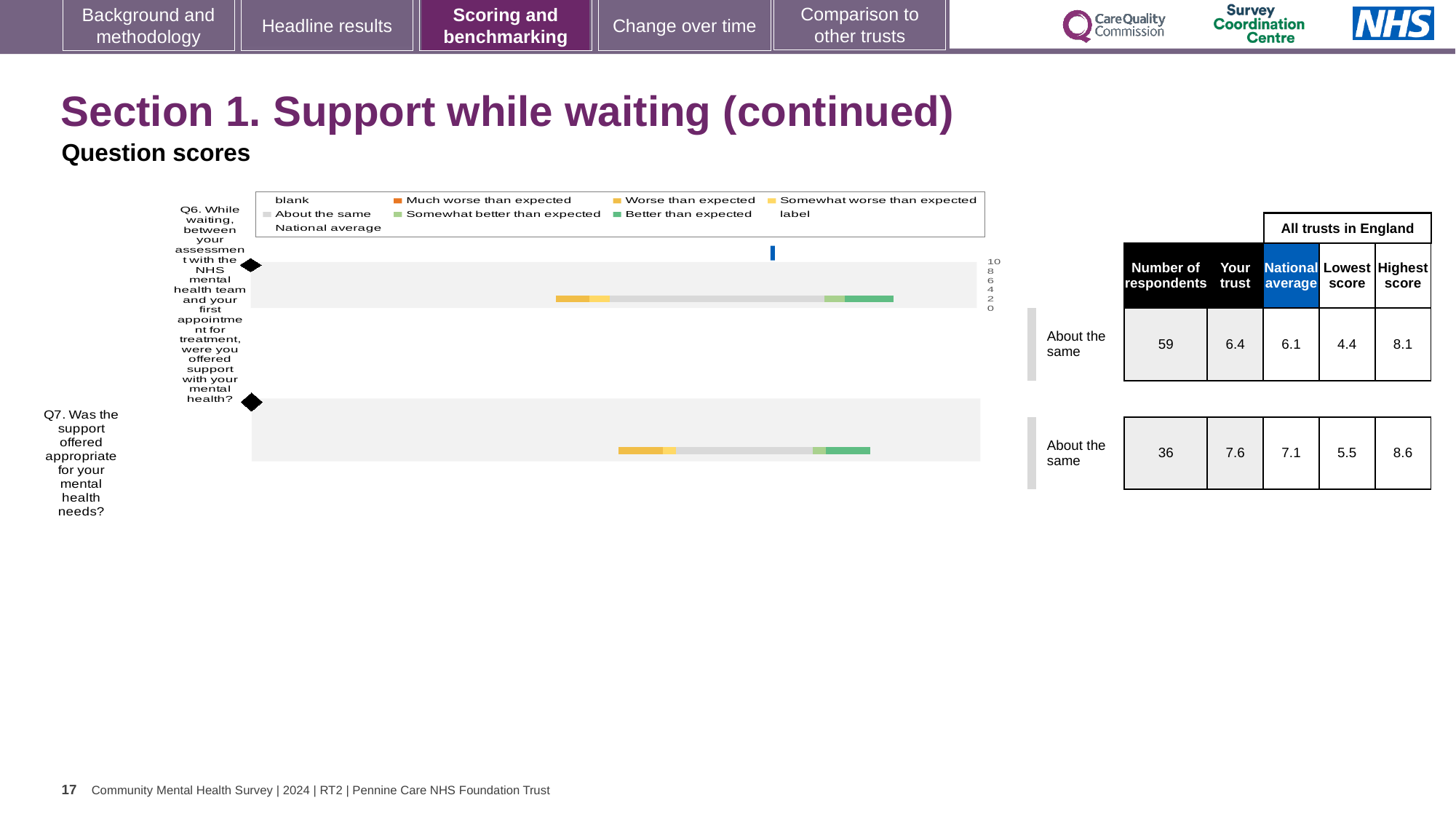
Which question has the higher 'Your trust' score, Q6 or Q7? Q7 What is the difference between the highest and lowest scores for Q6 among all trusts in England? 3.7 What is the lowest score among all trusts in England for Q7? 5.5 What benchmark category is shown for both Q6 and Q7? About the same How many survey questions are plotted in the chart? 2 By how much does the 'Your trust' score for Q7 exceed the national average for Q7? 0.5 How many respondents answered Q6? 59 What is the highest score among all trusts in England for Q7? 8.6 What is the 'Your trust' score for Q6 in the table beside the chart? 6.4 According to the legend, what does the blue vertical marker in the chart represent? National average What is the national average score for Q7 in the table beside the chart? 7.1 What kind of chart is shown on the slide? bar chart